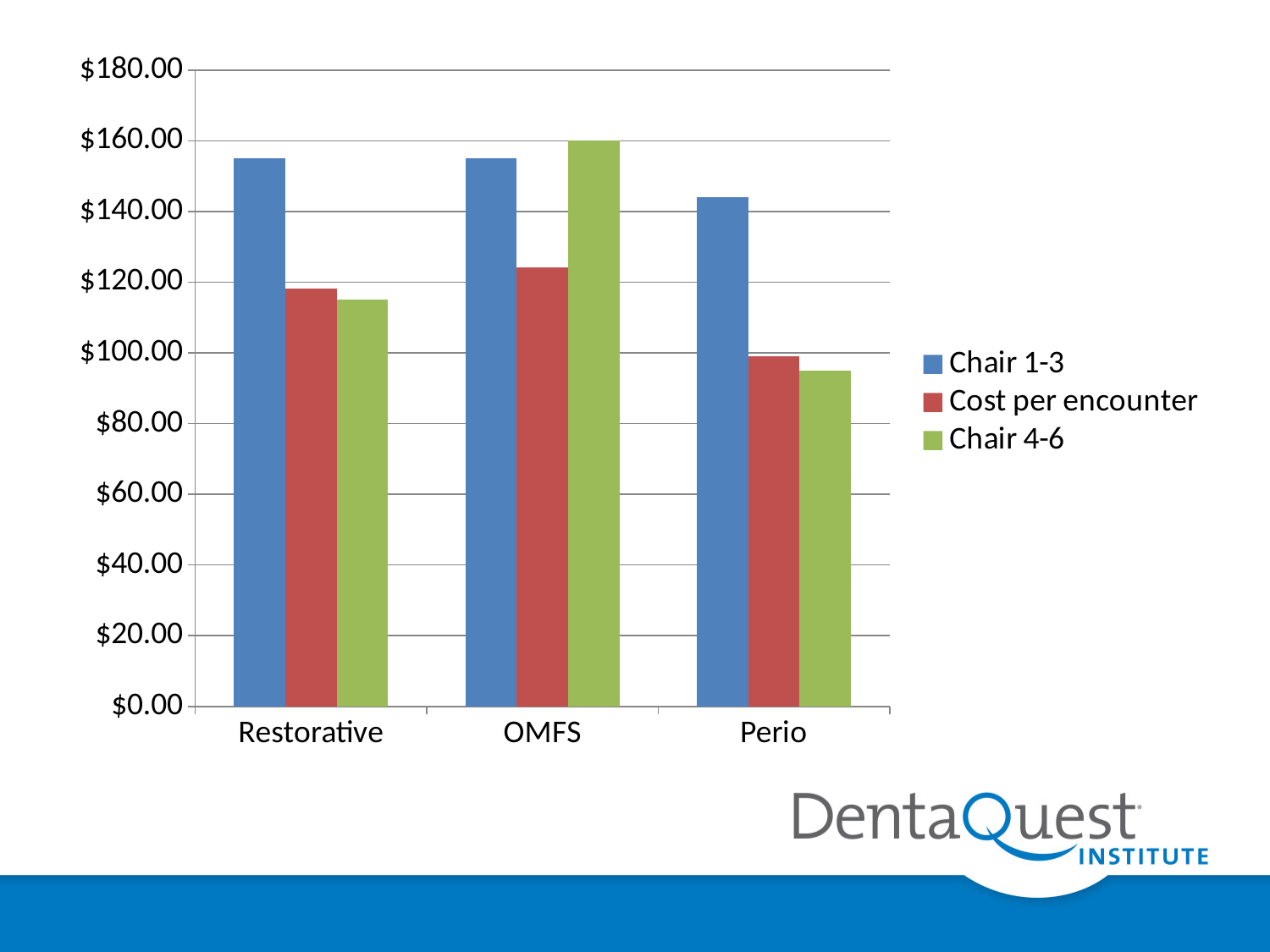
Which category has the highest Chair 4-6 value? OMFS What kind of chart is shown on the slide? bar chart For Perio, which is larger: the Chair 1-3 value or the Chair 4-6 value? Chair 1-3 For OMFS, which is larger: the Chair 1-3 value or the Cost per encounter value? Chair 1-3 How many categories are shown on the x axis? 3 Is the Chair 4-6 value for Restorative greater or less than $120.00? less Which category has the lowest Cost per encounter value? Perio Which colour represents the Cost per encounter series in the legend? red How many series does the legend list? 3 Which category has the lowest Chair 4-6 value? Perio Is the Chair 1-3 value for Perio greater or less than $140.00? greater